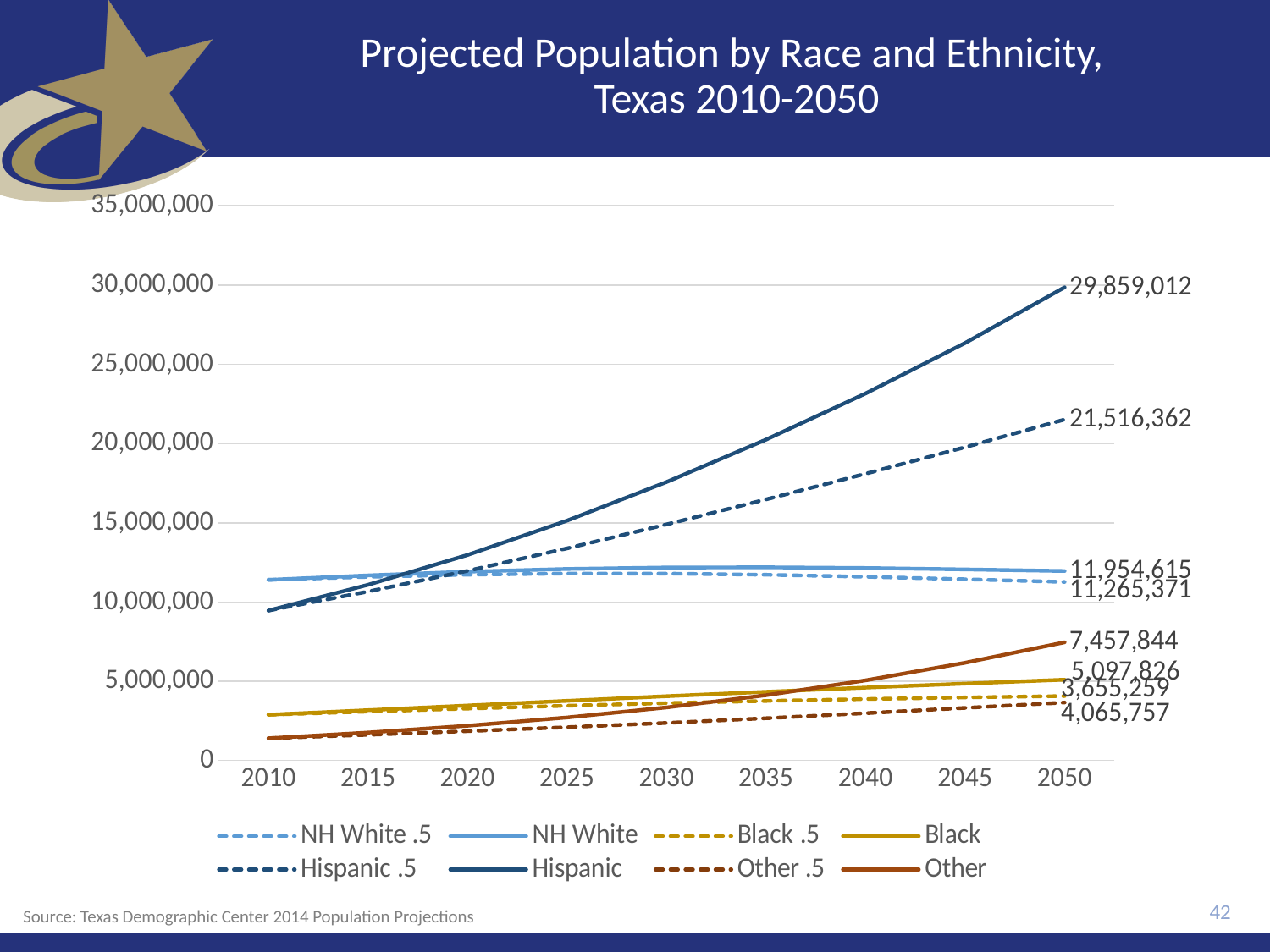
What type of chart is shown on the slide? line chart What is the projected Hispanic population in 2050? 29,859,012 Which series has the highest value in 2050? Hispanic What is the projected NH White population in 2050? 11,954,615 Which is larger in 2050, the Other series or the Black series? Other How many years are marked on the x axis? 9 What is the difference between the Hispanic and Hispanic .5 values in 2050? 8,342,650 How many series does the legend list? 8 Does the Hispanic series rise or fall from 2010 to 2050? rise Is the Hispanic value in 2010 greater or less than 10,000,000? less What is the projected value for the Other series in 2050? 7,457,844 What is the projected value for the Hispanic .5 series in 2050? 21,516,362